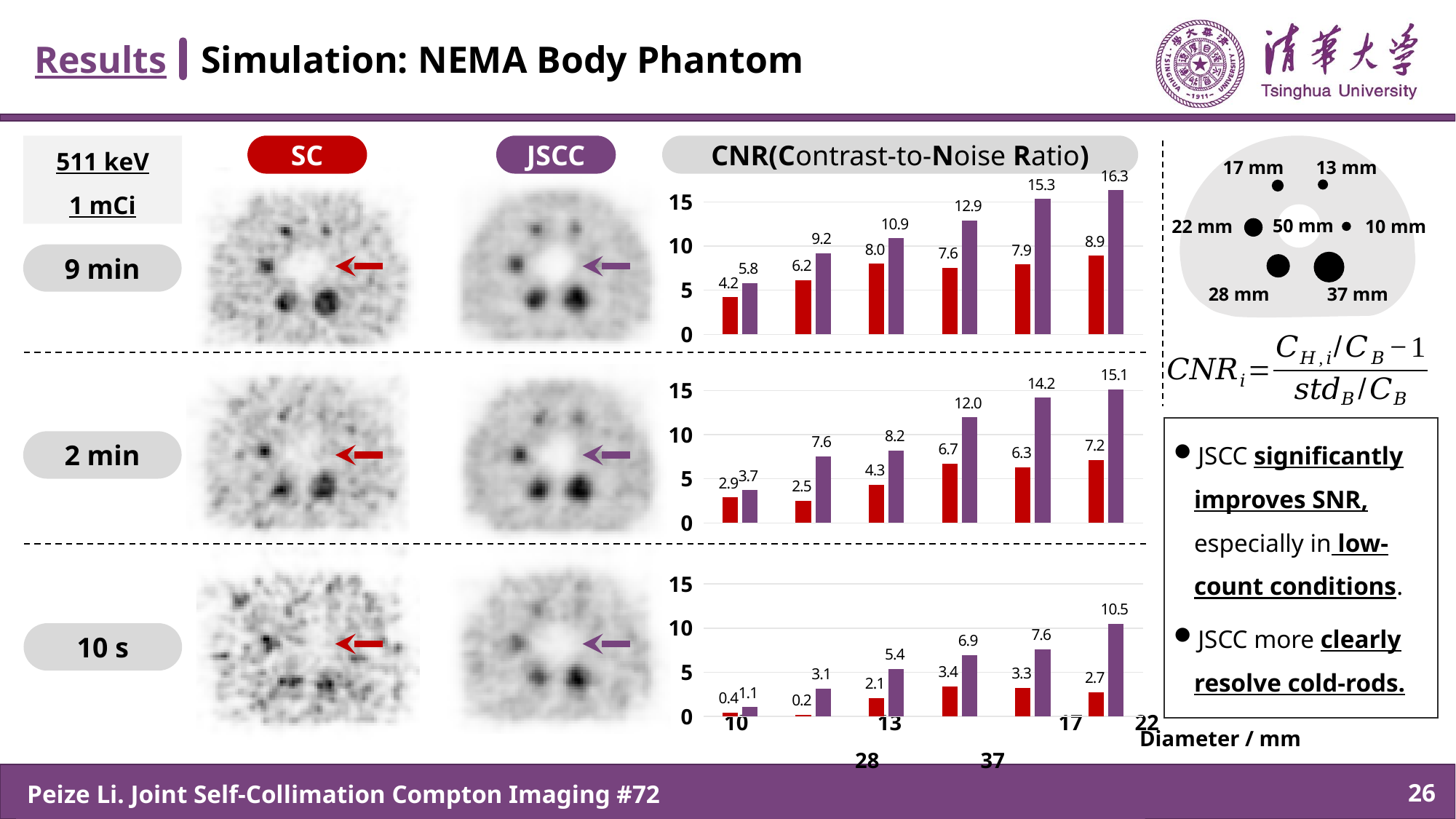
In the 9 min CNR chart, what is the highest JSCC (purple) value? 16.3 How many groups of bars does each CNR chart contain? 6 In the 9 min CNR chart, do the JSCC (purple) values rise or fall from left to right? Rise What kind of chart is used to show the CNR values on this slide? Bar chart In the 10 s CNR chart, what is the lowest SC (red) value? 0.2 Which colour represents the JSCC series in the CNR charts? Purple In the 9 min CNR chart, what is the SC (red) value for the leftmost group of bars? 4.2 In the 2 min CNR chart, what is the lowest SC (red) value? 2.5 In the 10 s CNR chart, what is the highest JSCC (purple) value? 10.5 In the 9 min CNR chart, what is the difference between the JSCC and SC values in the rightmost group of bars? 7.4 In the 2 min CNR chart, what is the JSCC (purple) value for the fourth group of bars from the left? 12.0 In the 2 min CNR chart, which is larger in the rightmost group of bars, the SC value or the JSCC value? JSCC